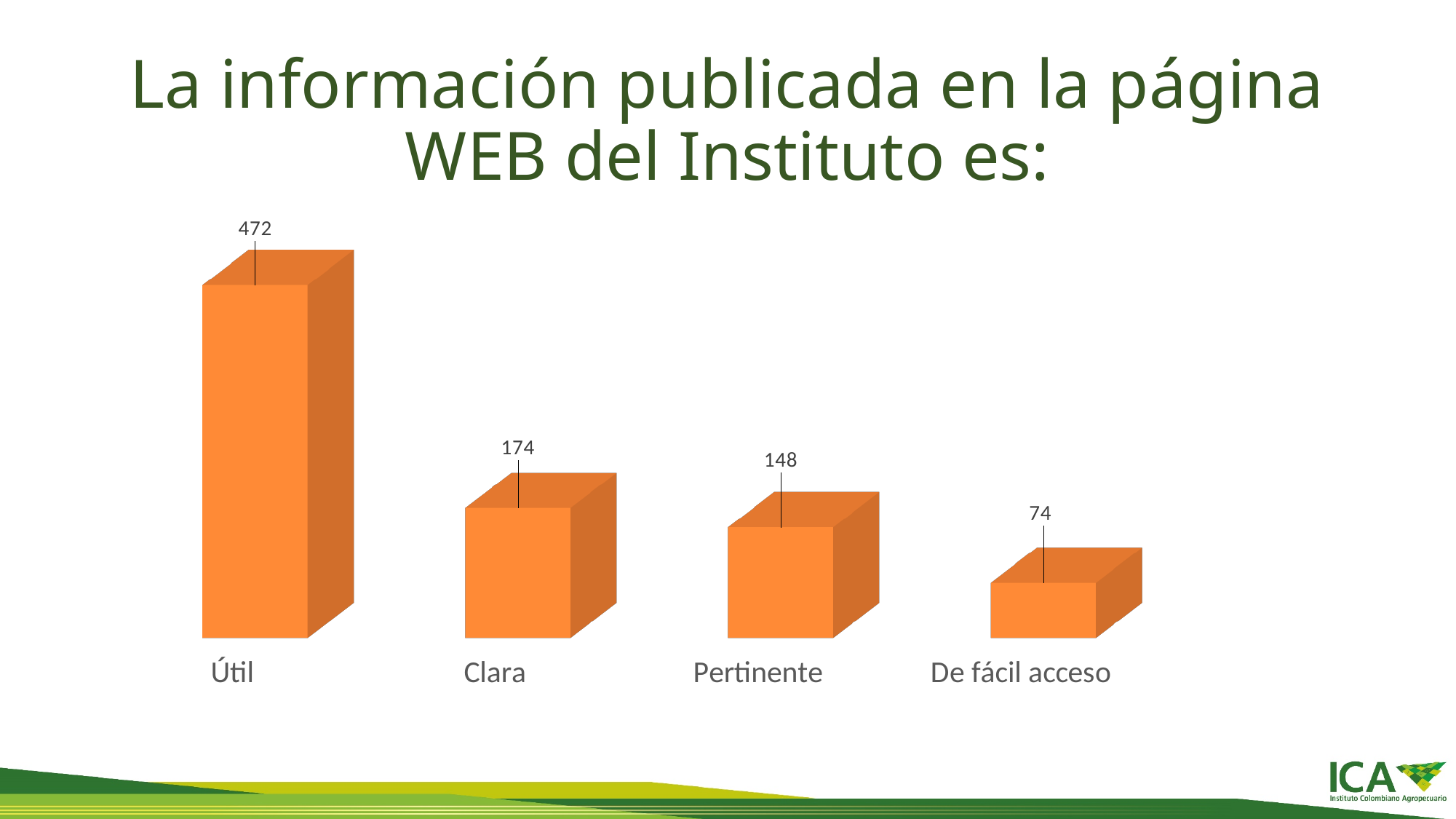
How many categories are shown in the chart? 4 What is the difference between the values for Útil and Clara? 298 What kind of chart is shown on the slide? Bar chart Which category has the lowest value? De fácil acceso What is the value for Clara? 174 What is the value for Pertinente? 148 What is the value for Útil? 472 What is the difference between the values for Pertinente and De fácil acceso? 74 Do the values rise or fall from left to right across the categories? Fall Which is larger, the value for Clara or the value for Pertinente? Clara What is the value for De fácil acceso? 74 Which category has the highest value? Útil